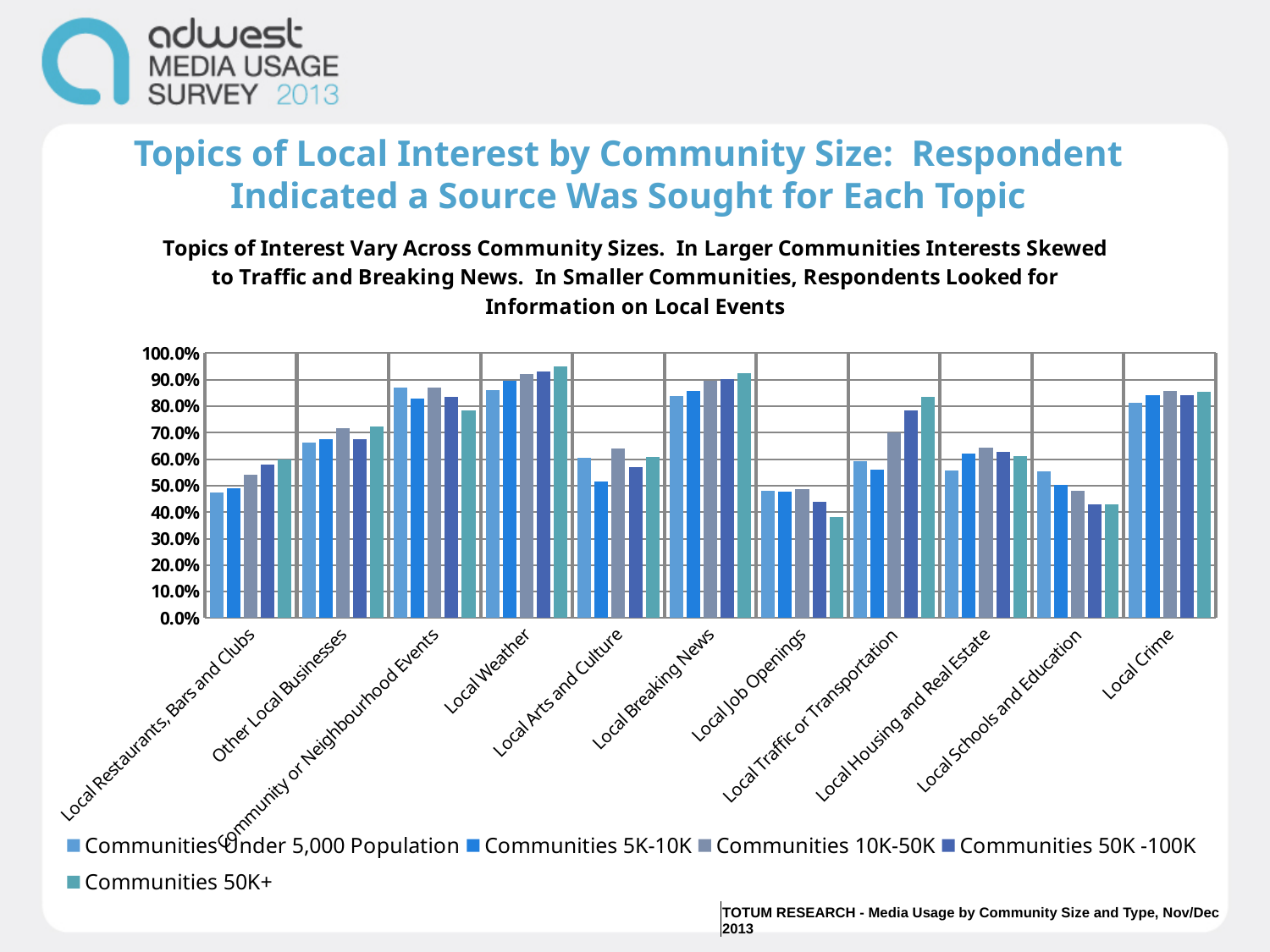
How many series does the legend list? 5 Is the value for Local Breaking News for Communities Under 5,000 Population greater or less than 80%? greater How many topic categories are shown along the x axis? 11 Is the value for Local Restaurants, Bars and Clubs for Communities Under 5,000 Population greater or less than 50%? less Is the value for Local Weather for Communities 50K+ greater or less than 90%? greater For Local Restaurants, Bars and Clubs, which is larger: the value for Communities Under 5,000 Population or for Communities 50K+? Communities 50K+ What kind of chart is shown on the slide? bar chart For Local Traffic or Transportation, which is larger: the value for Communities Under 5,000 Population or for Communities 50K+? Communities 50K+ Which topic has the lowest value for Communities 50K+? Local Job Openings Which topic has the highest value for Communities 50K+? Local Weather What is the first series listed in the chart legend? Communities Under 5,000 Population